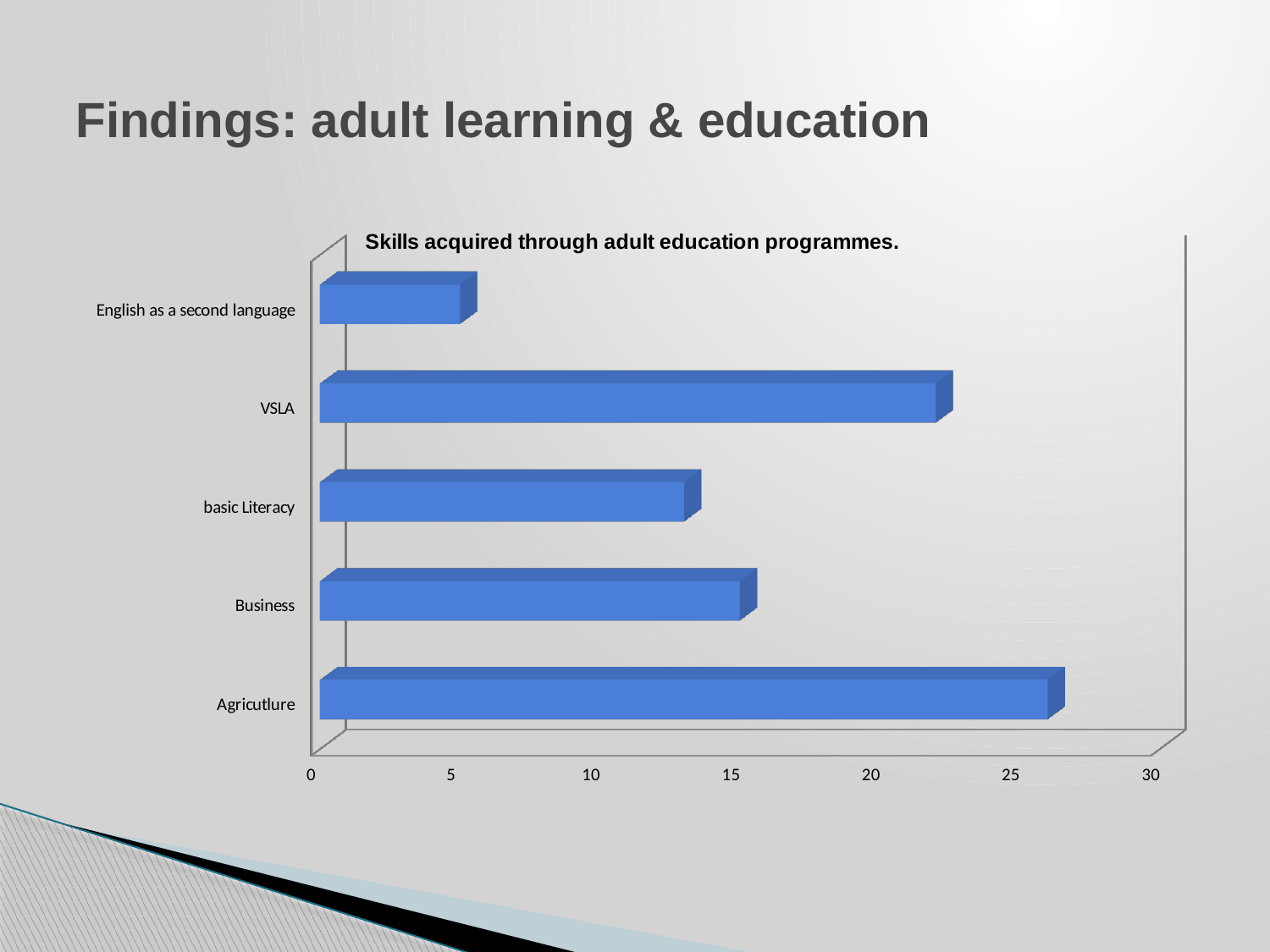
Which category has the lowest value? English as a second language Is the value for VSLA greater or less than 20? greater Is the value for Agricutlure greater or less than 20? greater Is the value for English as a second language greater or less than 10? less Which has a larger value, basic Literacy or English as a second language? basic Literacy How many categories are shown in the chart? 5 Which category has the highest value? Agricutlure What is the title of the chart? Skills acquired through adult education programmes. What kind of chart is shown on the slide? bar chart Which has a larger value, VSLA or Business? VSLA